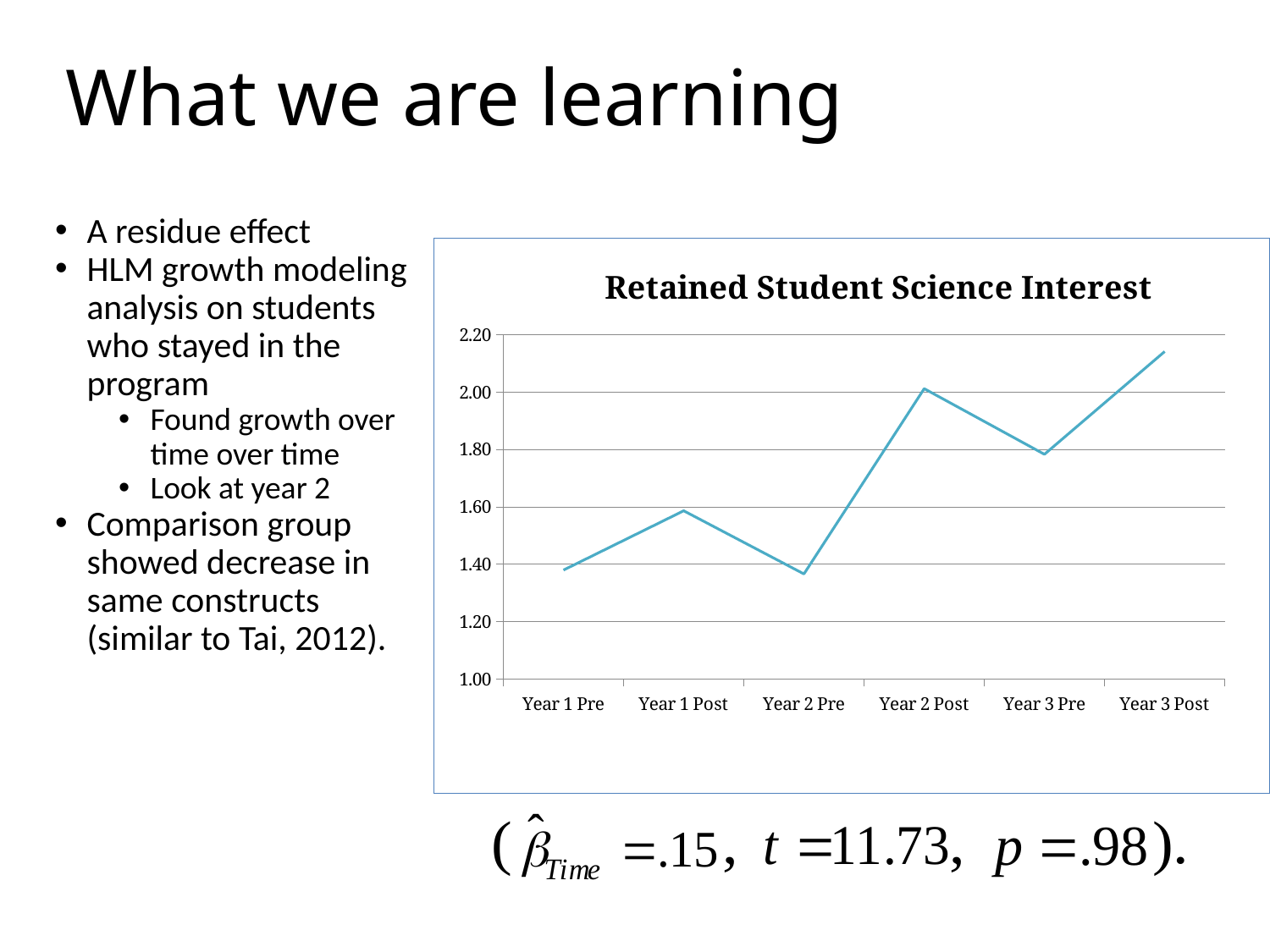
Is the value for Year 2 Post greater or less than 1.80? greater Which time point has the highest value in the chart? Year 3 Post Overall, do the values rise or fall from Year 1 Pre to Year 3 Post? rise What kind of chart is shown on the slide? line chart What is the title of the chart? Retained Student Science Interest Is the value for Year 2 Pre greater or less than 1.60? less Is the value for Year 3 Pre greater or less than 1.60? greater How many time points are plotted on the x axis of the chart? 6 Which is larger, the value for Year 3 Pre or the value for Year 2 Pre? Year 3 Pre Which is larger, the value for Year 2 Post or the value for Year 1 Post? Year 2 Post